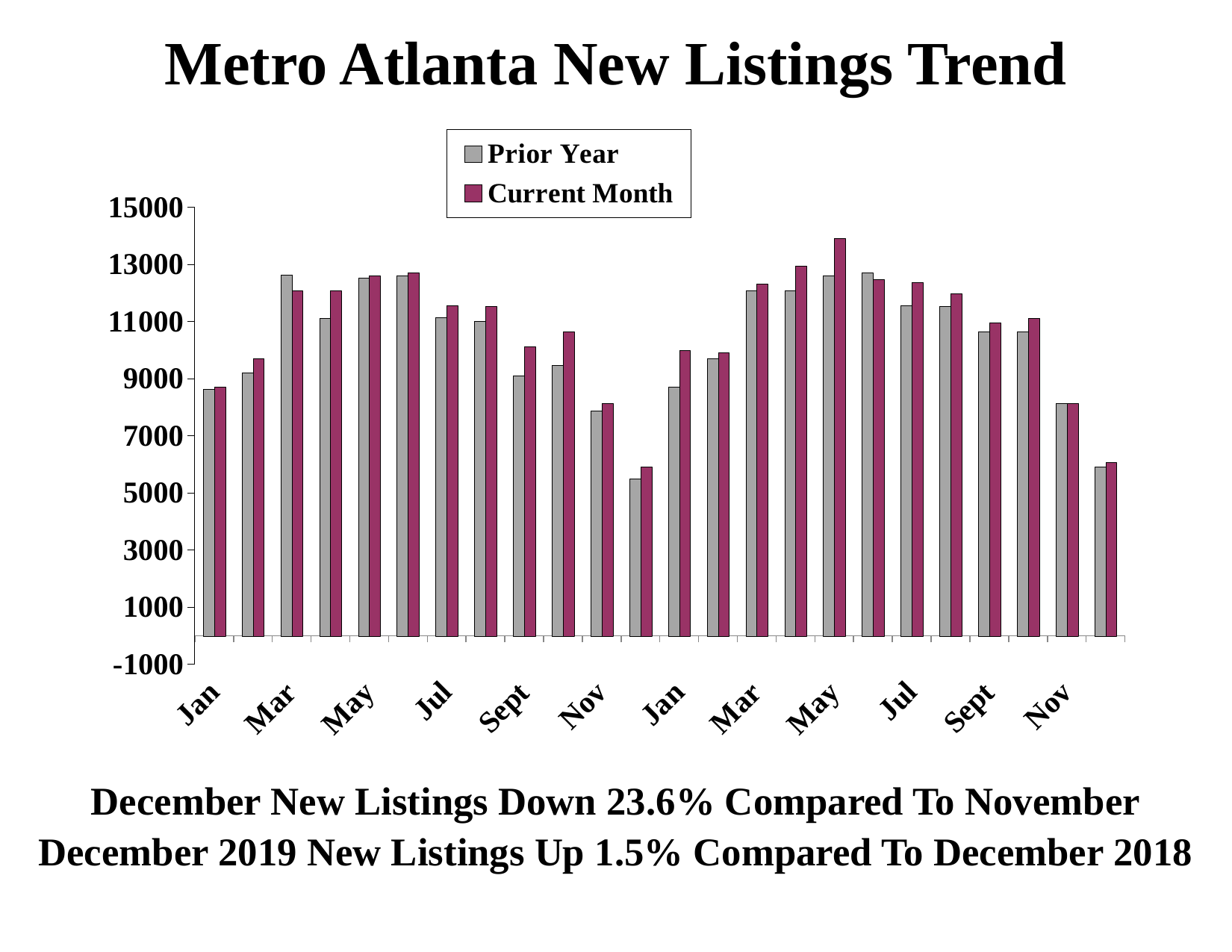
What are the two series named in the legend? Prior Year and Current Month How many series does the legend list? 2 What is the title of the chart? Metro Atlanta New Listings Trend For the second May on the axis, which series has the larger value, Prior Year or Current Month? Current Month For the first Mar on the axis, which series has the larger value, Prior Year or Current Month? Prior Year At which labeled month does the Current Month series reach its highest value? The second May Is the Prior Year value for the first Mar on the axis greater or less than 11000? greater Is the Current Month value for the first Jan on the axis greater or less than 9000? less Is the Current Month value for the first Sept on the axis greater or less than 11000? less What kind of chart is shown on the slide? Bar chart